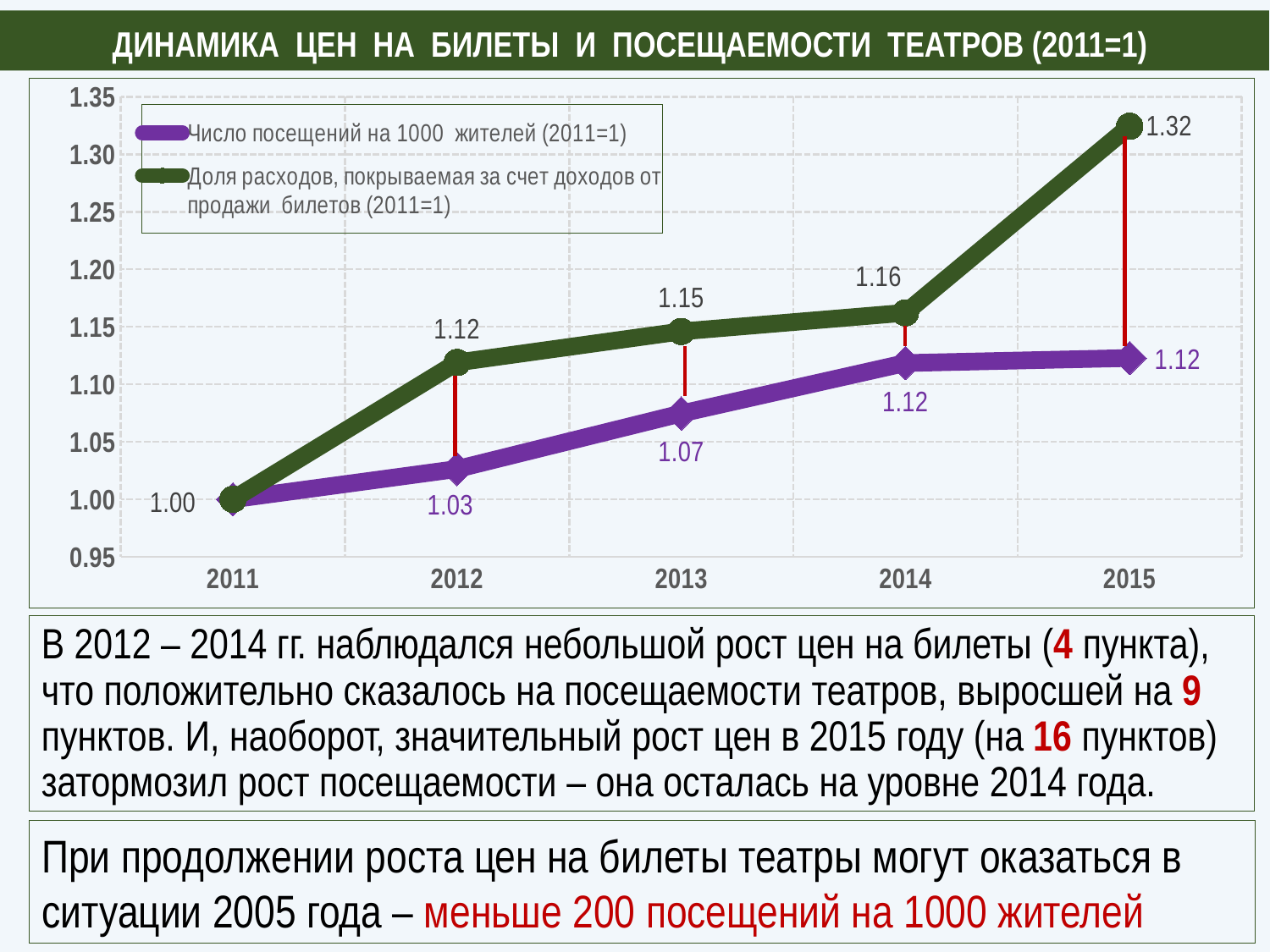
How many years are shown on the x axis? 5 What is the value of 'Число посещений на 1000 жителей (2011=1)' in 2013? 1.07 Does 'Число посещений на 1000 жителей (2011=1)' rise or fall from 2011 to 2014? rise What is the value of 'Доля расходов, покрываемая за счет доходов от продажи билетов (2011=1)' in 2014? 1.16 What type of chart is shown on the slide? line chart How many series does the legend list? 2 What is the value of 'Число посещений на 1000 жителей (2011=1)' in 2012? 1.03 What is the value of 'Доля расходов, покрываемая за счет доходов от продажи билетов (2011=1)' in 2015? 1.32 What is the difference between the two series in 2015? 0.20 Which series has the larger value in 2013? Доля расходов, покрываемая за счет доходов от продажи билетов (2011=1) What colour is the line for 'Число посещений на 1000 жителей (2011=1)'? purple In which year does 'Доля расходов, покрываемая за счет доходов от продажи билетов (2011=1)' reach its highest value? 2015